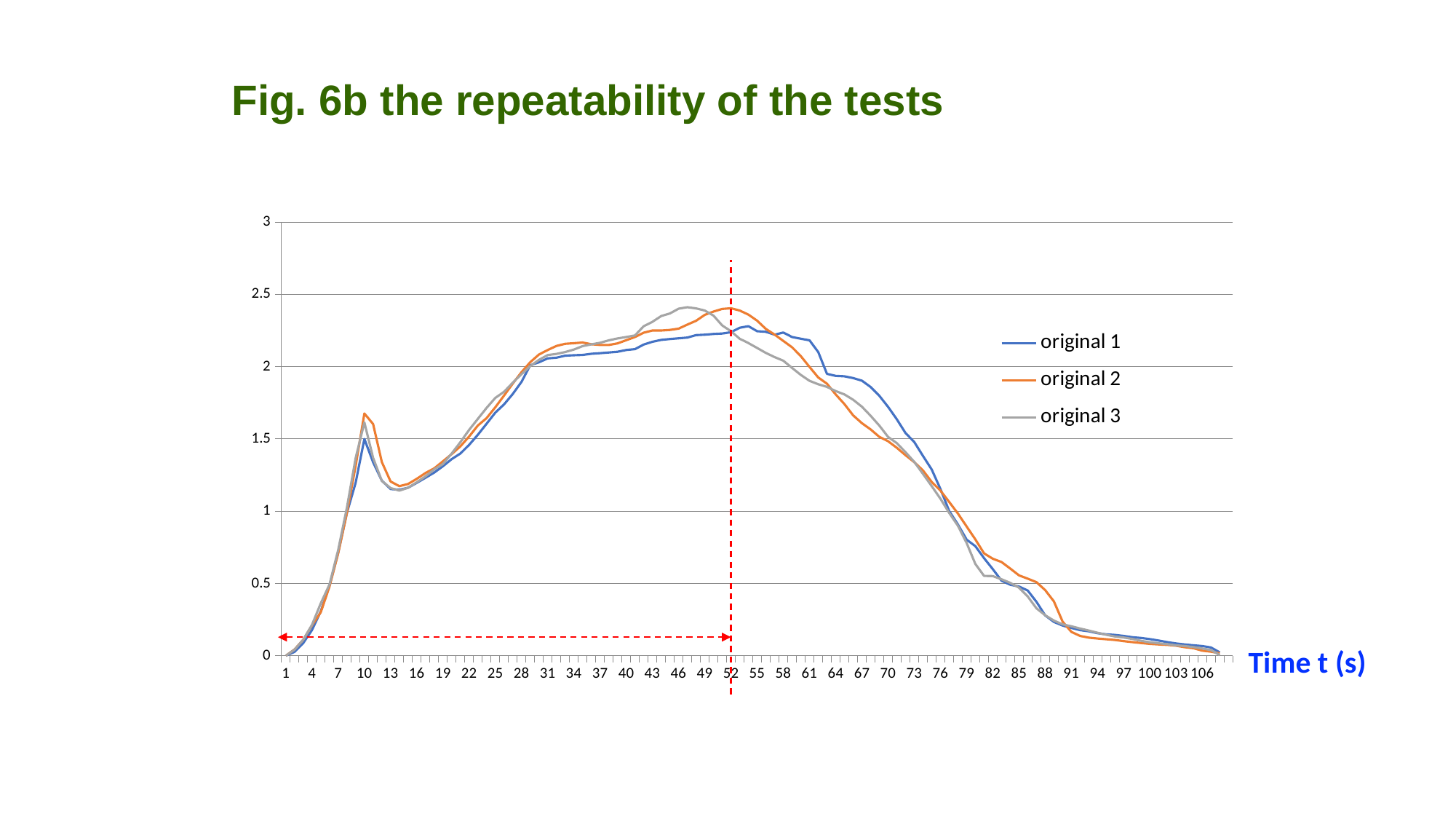
What is the title of the chart on the slide? Fig. 6b the repeatability of the tests At time 10, which series has the higher value, original 1 or original 2? original 2 Is the value of original 2 at time 10 greater or less than 1.5? greater Is the value of original 3 at time 79 greater or less than 1? less Is the value of original 3 at time 46 greater or less than 2? greater What is the label of the x axis? Time t (s) What kind of chart is shown on the slide? line chart At time 67, which series has the higher value, original 1 or original 2? original 1 Do the values of original 2 rise or fall between time 52 and time 106? fall How many series does the legend list? 3